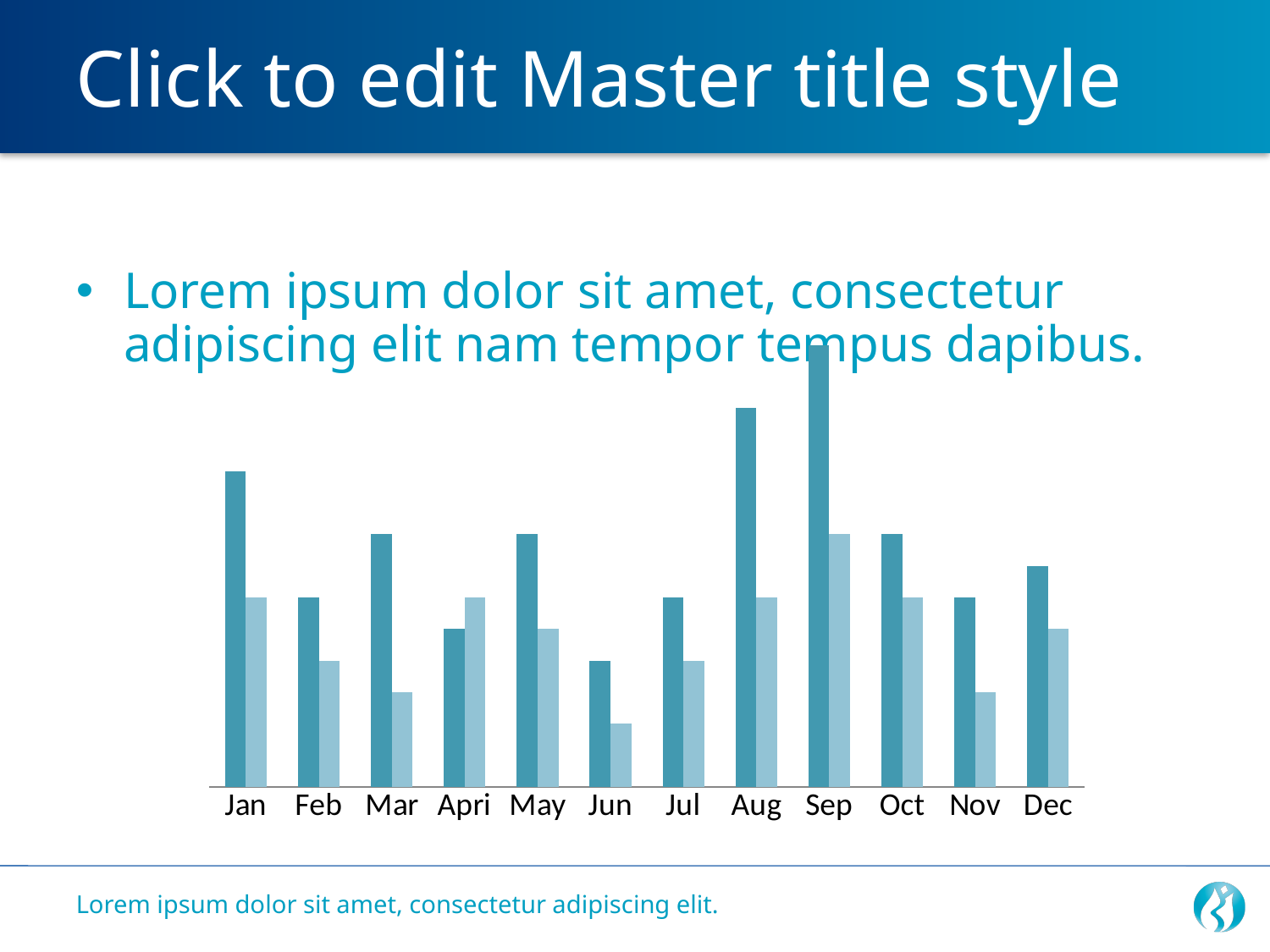
Which category has the shortest light blue bar? Jun Is the dark blue bar for Jan taller or shorter than the dark blue bar for Feb? taller In Apri, which bar is taller, the dark blue one or the light blue one? the light blue one Which category has the tallest light blue bar? Sep Which category has the tallest bar in the chart? Sep Which category has the shortest bar in the chart? Jun How many categories are shown along the x axis of the chart? 12 Is the dark blue bar for Aug taller or shorter than the dark blue bar for Sep? shorter What is the label of the first category on the x axis? Jan How many bars are shown for each month in the chart? 2 What kind of chart is shown on the slide? bar chart Which category has the tallest dark blue bar? Sep